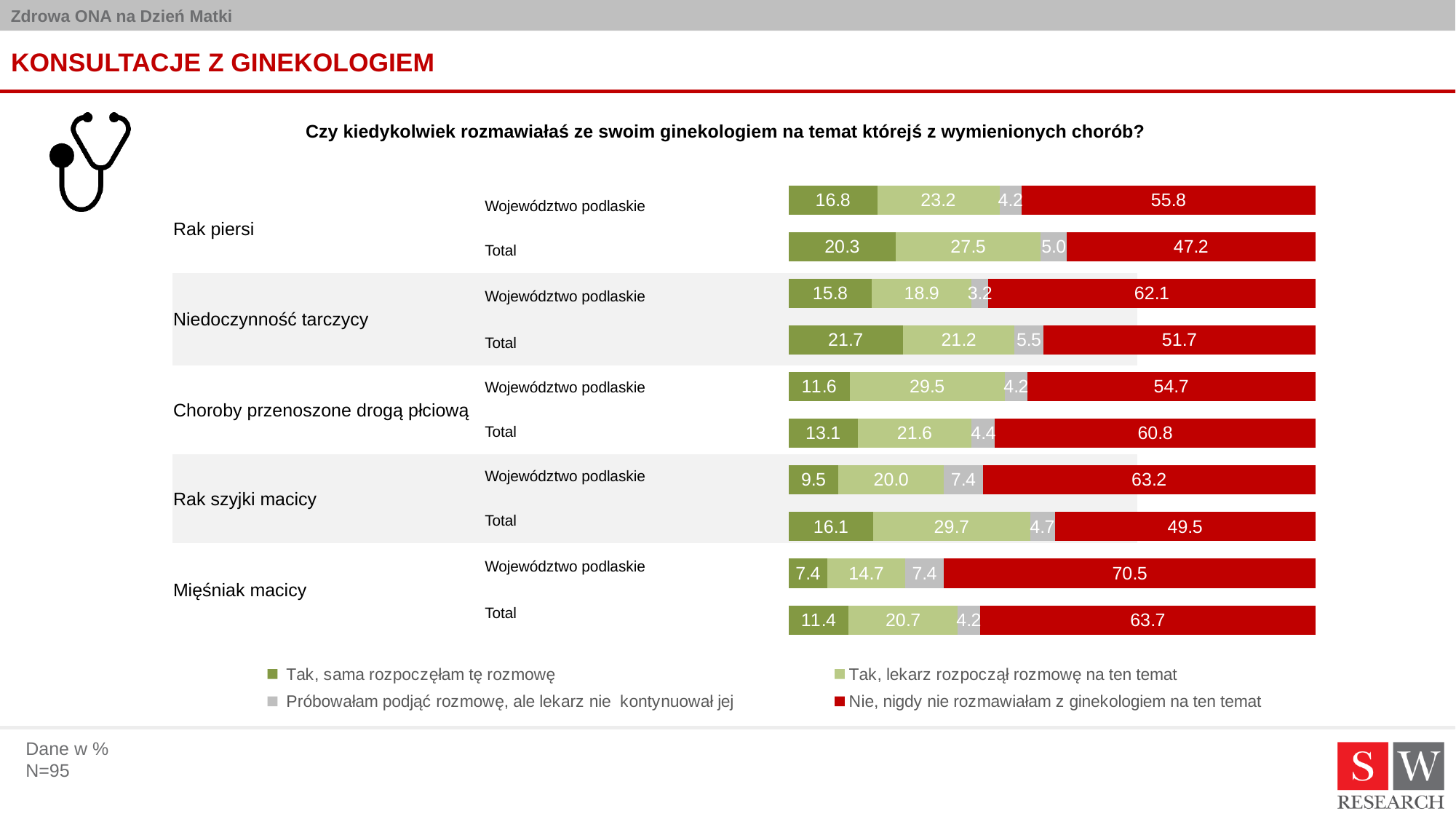
Among the Województwo podlaskie bars, which disease has the lowest value for "Tak, sama rozpoczęłam tę rozmowę"? Mięśniak macicy For Rak piersi, what is the difference between the Województwo podlaskie and Total values of "Nie, nigdy nie rozmawiałam z ginekologiem na ten temat"? 8.6 How many series does the legend list? 4 Which colour represents "Nie, nigdy nie rozmawiałam z ginekologiem na ten temat" in the chart? Red What is the value of "Tak, lekarz rozpoczął rozmowę na ten temat" for Choroby przenoszone drogą płciową, Województwo podlaskie? 29.5 What kind of chart is shown on the slide? Stacked bar chart How many bars are plotted in the chart? 10 What is the value of "Próbowałam podjąć rozmowę, ale lekarz nie kontynuował jej" for Rak szyjki macicy, Województwo podlaskie? 7.4 For Rak szyjki macicy, which is larger for "Tak, lekarz rozpoczął rozmowę na ten temat": Województwo podlaskie or Total? Total What is the value of "Tak, sama rozpoczęłam tę rozmowę" for Niedoczynność tarczycy, Total? 21.7 What is the value of "Nie, nigdy nie rozmawiałam z ginekologiem na ten temat" for Rak piersi, Województwo podlaskie? 55.8 Among the Województwo podlaskie bars, which disease has the highest value for "Nie, nigdy nie rozmawiałam z ginekologiem na ten temat"? Mięśniak macicy